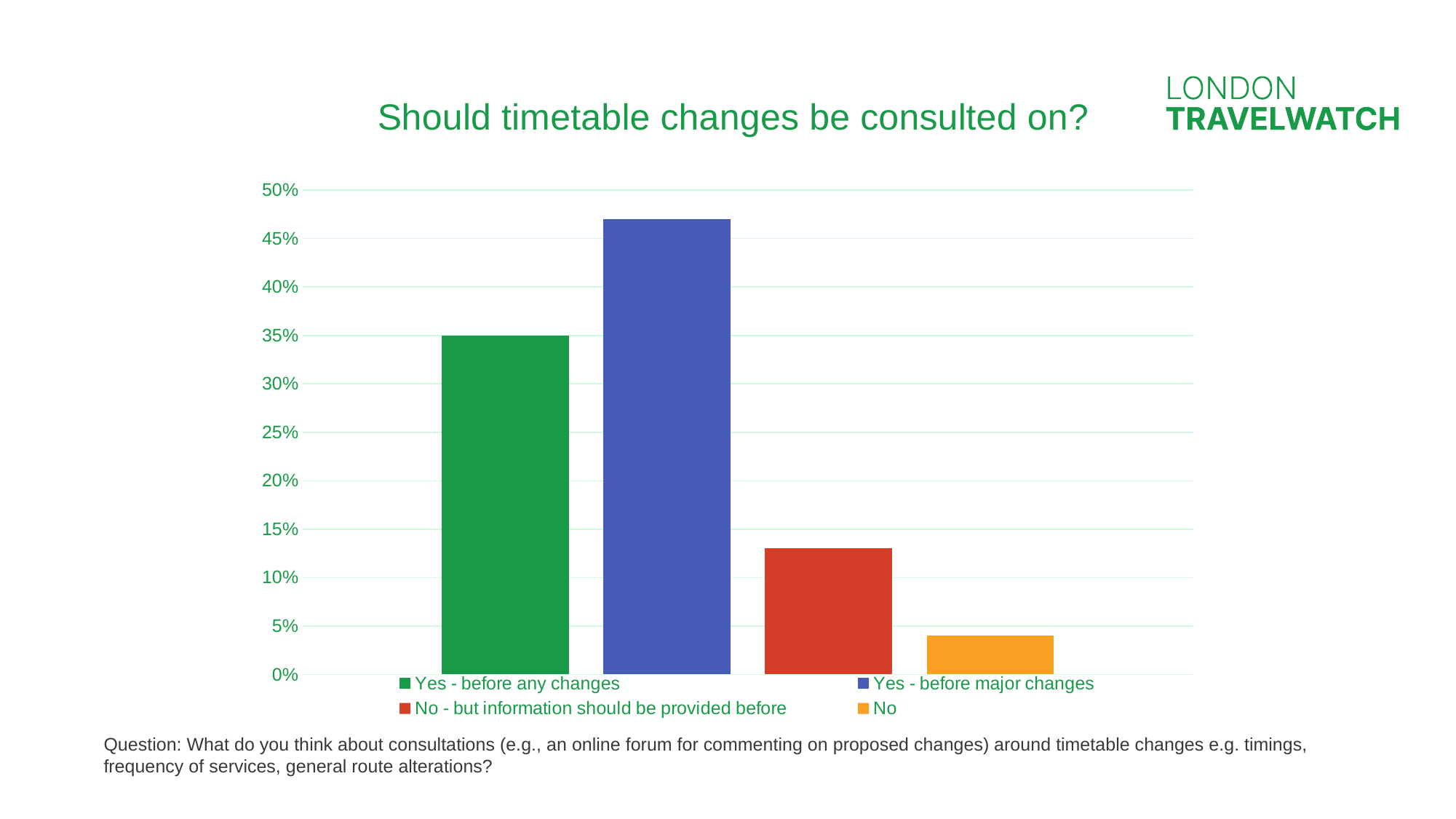
Which response has the highest value? Yes - before major changes What kind of chart is shown on the slide? bar chart Which response has the lowest value? No What colour is the bar for 'No'? orange How many bars are plotted in the chart? 4 Which is larger: the value for 'Yes - before any changes' or 'No - but information should be provided before'? Yes - before any changes Is the value for 'Yes - before major changes' greater or less than 45%? greater What is the title of the chart? Should timetable changes be consulted on? What is the value for 'Yes - before any changes'? 35% How many entries does the legend list? 4 Is the value for 'No' greater or less than 5%? less Is the value for 'No - but information should be provided before' greater or less than 15%? less